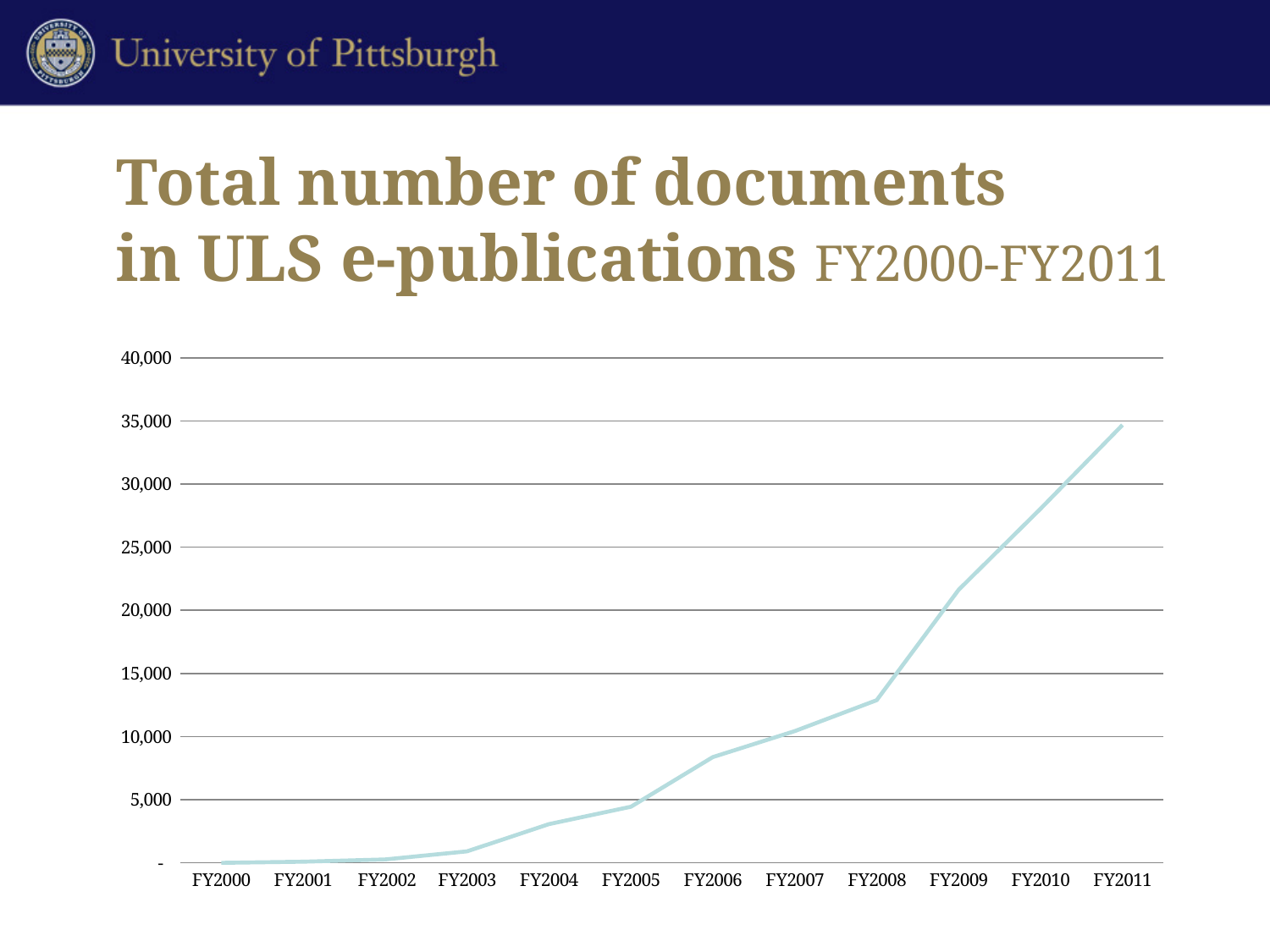
Which fiscal year has the lowest total number of documents? FY2000 What kind of chart is shown on the slide? line chart Is the value for FY2006 greater or less than 5,000? greater Is the value for FY2009 greater or less than 20,000? greater Which fiscal year has the highest total number of documents? FY2011 Do the values rise or fall from FY2000 to FY2011? rise Is the value for FY2011 greater or less than 30,000? greater What is the highest value shown on the y axis? 40,000 How many fiscal years are plotted on the x axis? 12 Which is larger, the value for FY2009 or the value for FY2006? FY2009